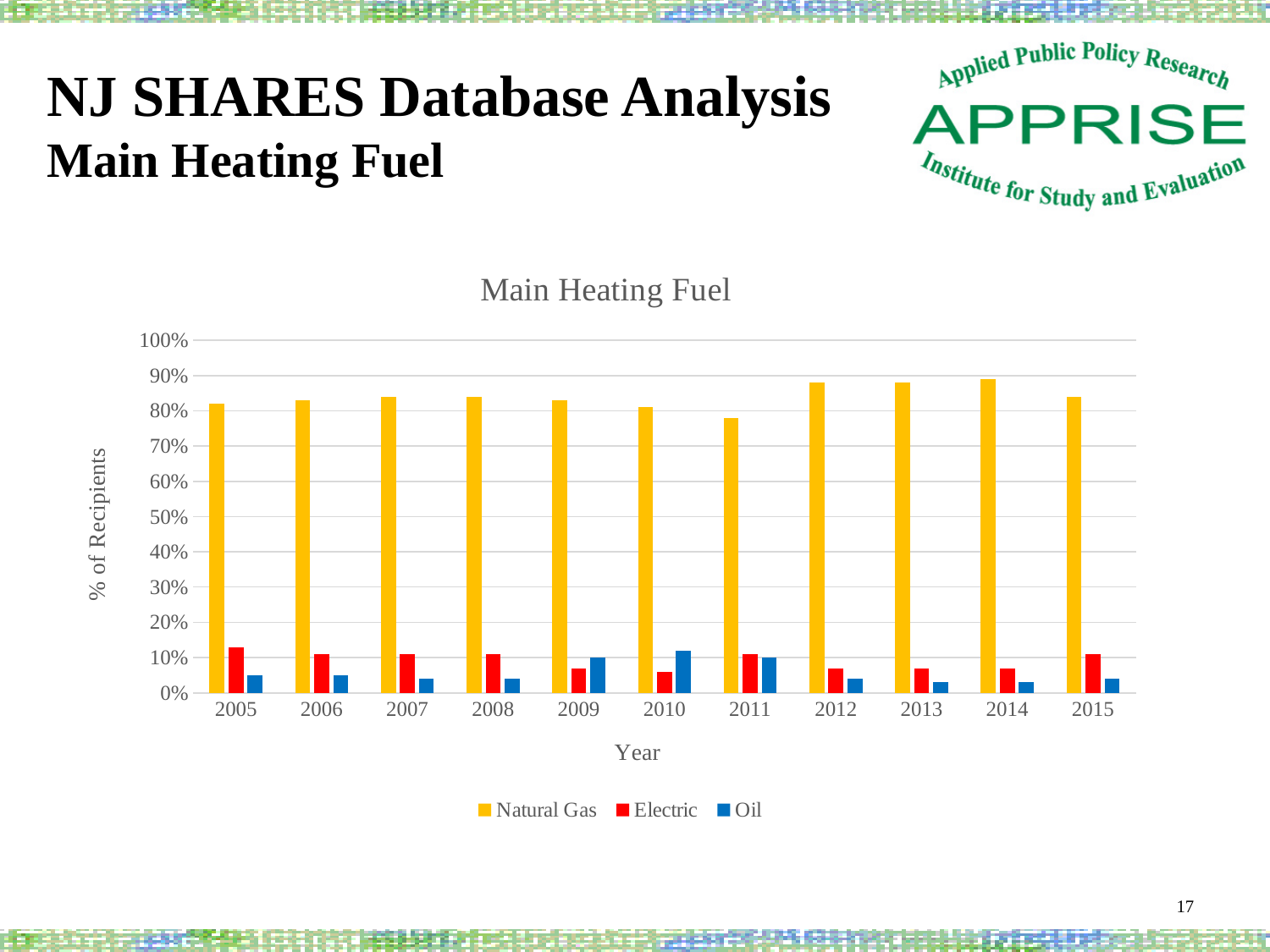
Is the Natural Gas value for 2011 greater or less than 80%? less In which year is the Natural Gas value lowest? 2011 How many years are shown on the x axis? 11 Is the Oil value for 2005 greater or less than 10%? less In which year is the Electric value highest? 2005 Is the Natural Gas value for 2014 greater or less than 80%? greater What kind of chart is shown on the slide? bar chart What is the title of the vertical axis? % of Recipients How many series does the legend list? 3 Which is larger, the Natural Gas value for 2012 or for 2011? 2012 Which is larger, the Oil value for 2010 or for 2012? 2010